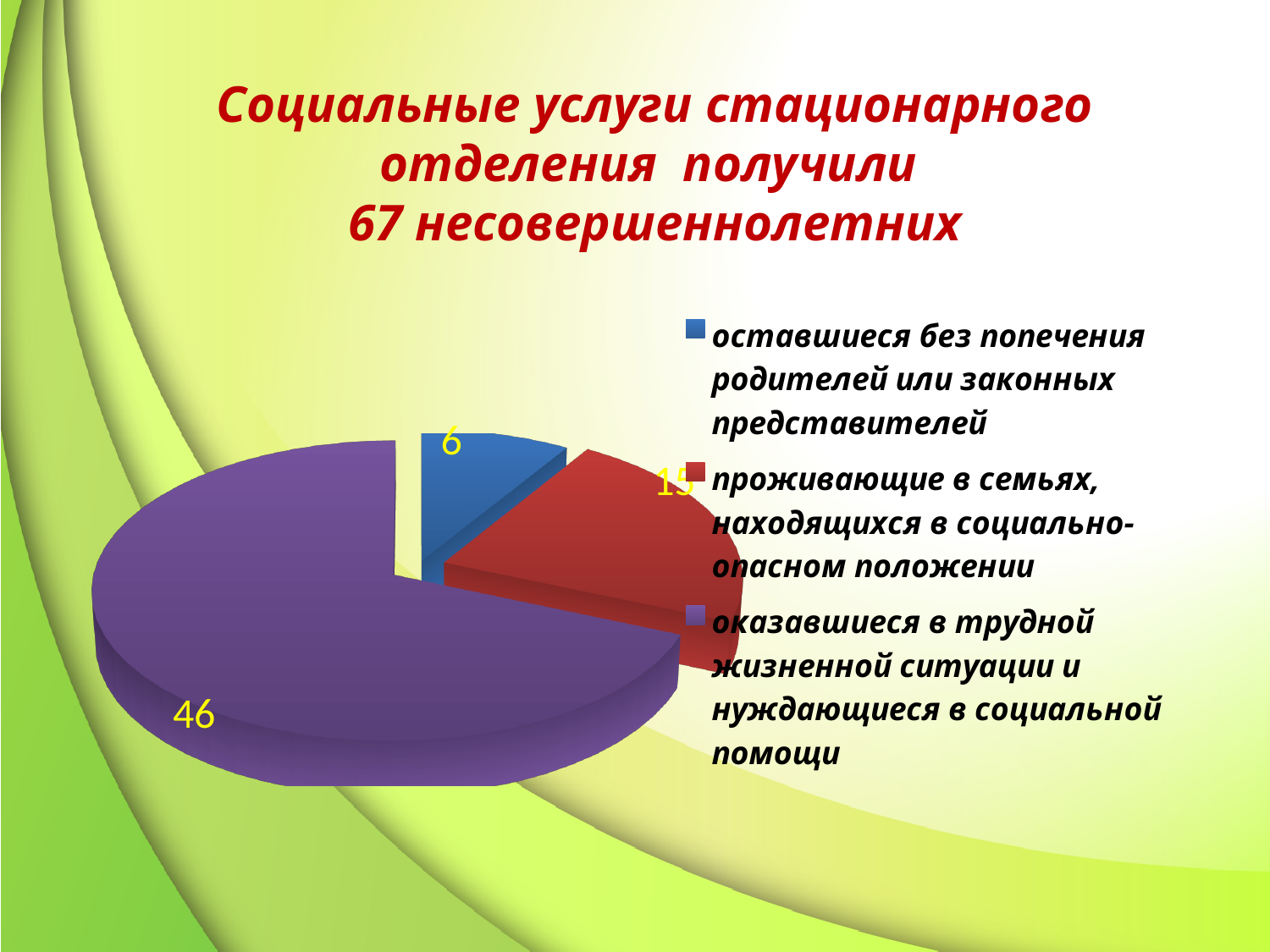
What kind of chart is shown on the slide? pie chart By how much does the value for 'проживающие в семьях, находящихся в социально-опасном положении' exceed the value for 'оставшиеся без попечения родителей или законных представителей'? 9 Which is larger: the value for 'проживающие в семьях, находящихся в социально-опасном положении' or the value for 'оставшиеся без попечения родителей или законных представителей'? проживающие в семьях, находящихся в социально-опасном положении Which category has the smallest slice of the pie? оставшиеся без попечения родителей или законных представителей Which category has the largest slice of the pie? оказавшиеся в трудной жизненной ситуации и нуждающиеся в социальной помощи What colour is the slice labelled 46? purple What value is shown for the slice 'проживающие в семьях, находящихся в социально-опасном положении'? 15 What value is shown for the slice 'оставшиеся без попечения родителей или законных представителей'? 6 What value is shown for the slice 'оказавшиеся в трудной жизненной ситуации и нуждающиеся в социальной помощи'? 46 What is the difference between the largest slice value (46) and the value for 'проживающие в семьях, находящихся в социально-опасном положении'? 31 How many slices does the pie chart have? 3 What is the total of all the slice values in the pie chart? 67